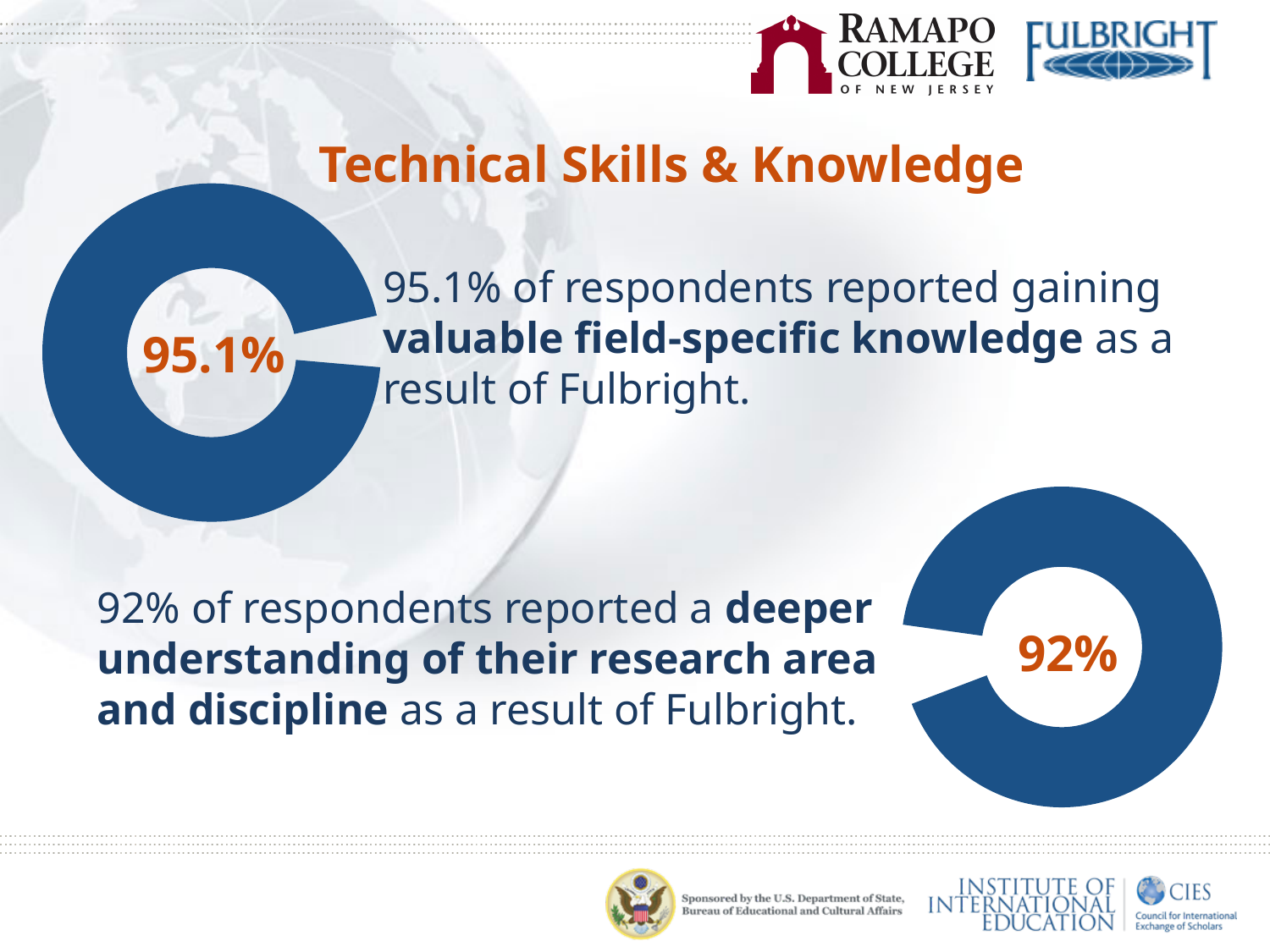
What percentage of respondents reported gaining valuable field-specific knowledge, according to the left donut chart? 95.1% What colour is the filled portion of the donut charts? Blue What value is shown in the centre of the donut chart on the right of the slide? 92% What value is shown in the centre of the donut chart on the left of the slide? 95.1% What is the difference between the value in the left donut chart and the value in the right donut chart? 3.1 percentage points What kind of chart is used to show the 95.1% figure? Donut (pie) chart In the left donut chart, what share of the ring is filled in? 95.1% How many donut charts are on the slide? 2 What percentage of respondents reported a deeper understanding of their research area and discipline, according to the right donut chart? 92% Which donut chart shows the larger value, the one on the left or the one on the right? The one on the left (95.1%) In the right donut chart, what share of the ring is left unfilled? 8% What is the title of the slide containing the two donut charts? Technical Skills & Knowledge